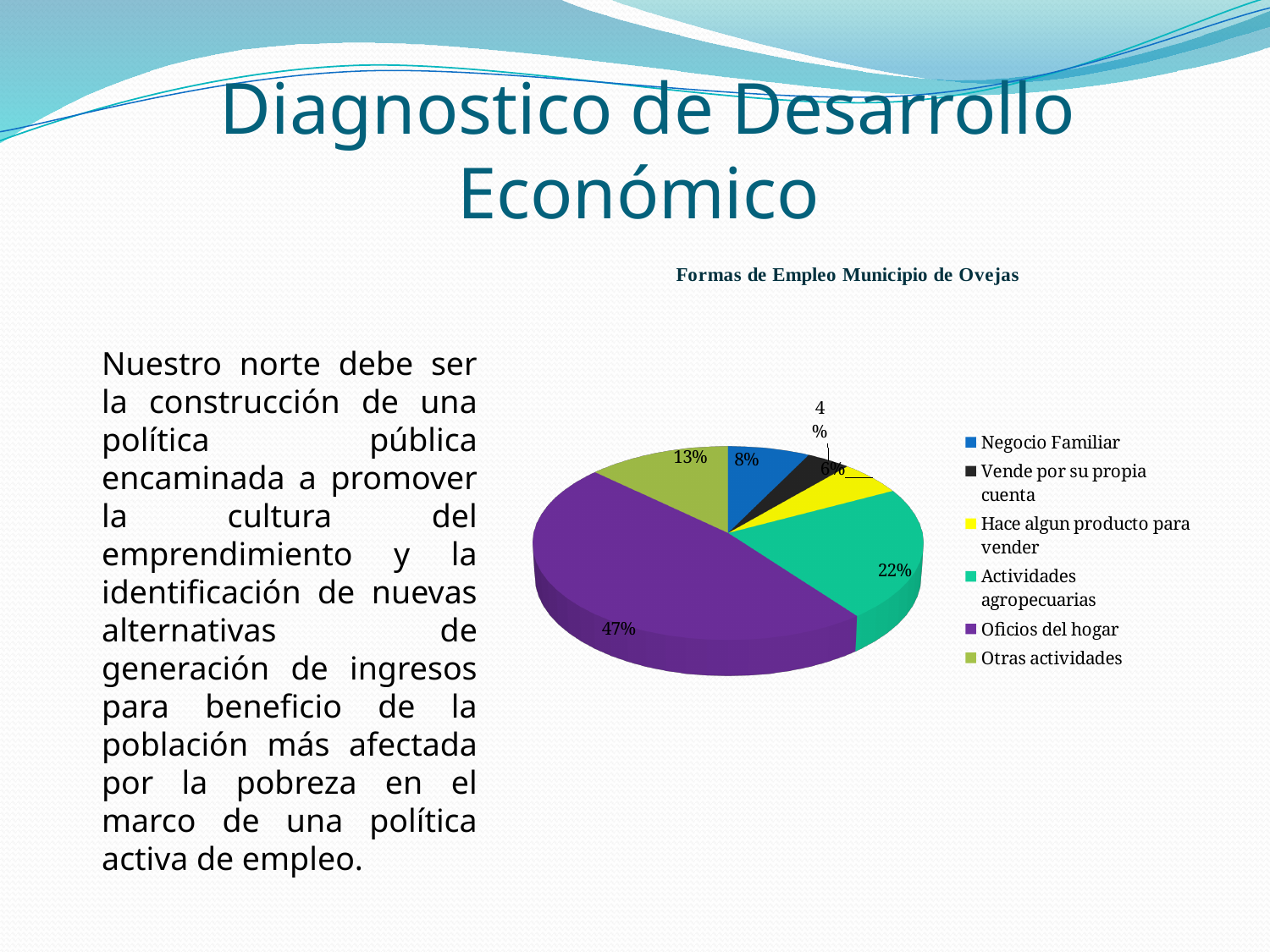
What is the title of the chart? Formas de Empleo Municipio de Ovejas What share of the pie does Actividades agropecuarias represent? 22% What is the difference between the shares of Oficios del hogar and Actividades agropecuarias? 25% How many categories does the legend of the pie chart list? 6 Which category has the smallest slice of the pie? Vende por su propia cuenta Which category has the largest slice of the pie? Oficios del hogar What is the value shown for Hace algun producto para vender? 6% What share of the pie does Oficios del hogar represent? 47% What is the value shown for Otras actividades? 13% What type of chart is shown on the slide? Pie chart What is the value shown for Negocio Familiar? 8% Which is larger, the share for Otras actividades or the share for Negocio Familiar? Otras actividades